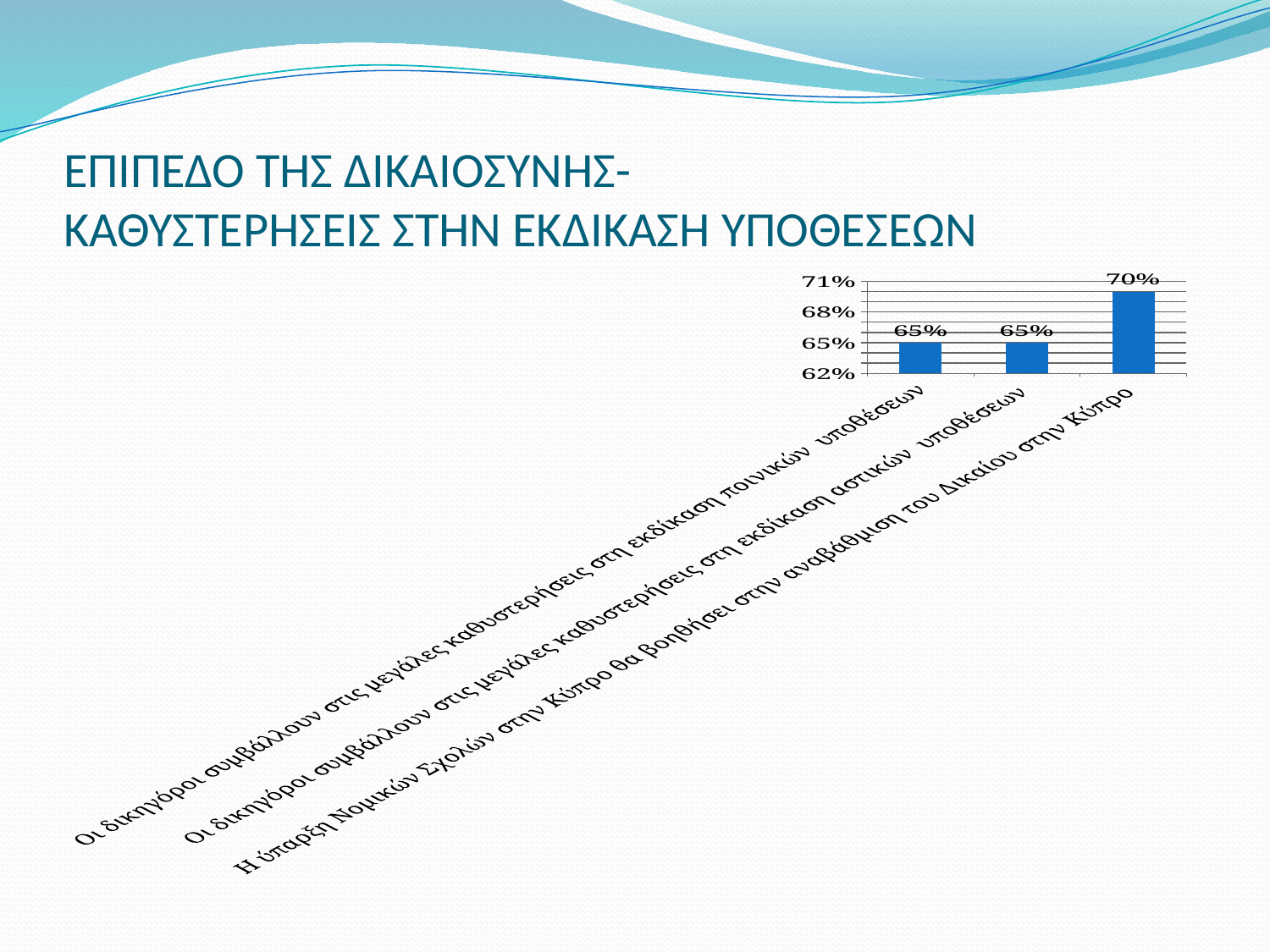
What is the value for "Οι δικηγόροι συμβάλλουν στις μεγάλες καθυστερήσεις στη εκδίκαση ποινικών υποθέσεων"? 65% What is the difference between the value for "Η ύπαρξη Νομικών Σχολών στην Κύπρο θα βοηθήσει στην αναβάθμιση του Δικαίου στην Κύπρο" and the value for "Οι δικηγόροι συμβάλλουν στις μεγάλες καθυστερήσεις στη εκδίκαση ποινικών υποθέσεων"? 5% Which is larger: the value for "Η ύπαρξη Νομικών Σχολών στην Κύπρο θα βοηθήσει στην αναβάθμιση του Δικαίου στην Κύπρο" or the value for "Οι δικηγόροι συμβάλλουν στις μεγάλες καθυστερήσεις στη εκδίκαση αστικών υποθέσεων"? Η ύπαρξη Νομικών Σχολών στην Κύπρο θα βοηθήσει στην αναβάθμιση του Δικαίου στην Κύπρο What kind of chart is shown on the slide? bar chart What is the value for "Οι δικηγόροι συμβάλλουν στις μεγάλες καθυστερήσεις στη εκδίκαση αστικών υποθέσεων"? 65% Is the value for "Η ύπαρξη Νομικών Σχολών στην Κύπρο θα βοηθήσει στην αναβάθμιση του Δικαίου στην Κύπρο" greater or less than 68%? greater What is the value for "Η ύπαρξη Νομικών Σχολών στην Κύπρο θα βοηθήσει στην αναβάθμιση του Δικαίου στην Κύπρο"? 70% Which category has the highest value in the chart? Η ύπαρξη Νομικών Σχολών στην Κύπρο θα βοηθήσει στην αναβάθμιση του Δικαίου στην Κύπρο Is the value for "Οι δικηγόροι συμβάλλουν στις μεγάλες καθυστερήσεις στη εκδίκαση ποινικών υποθέσεων" greater or less than 68%? less Do the two categories about lawyers contributing to delays (ποινικών and αστικών υποθέσεων) have the same value? Yes, both 65% How many bars (categories) does the chart show? 3 What is the lowest value shown on the vertical axis of the chart? 62%